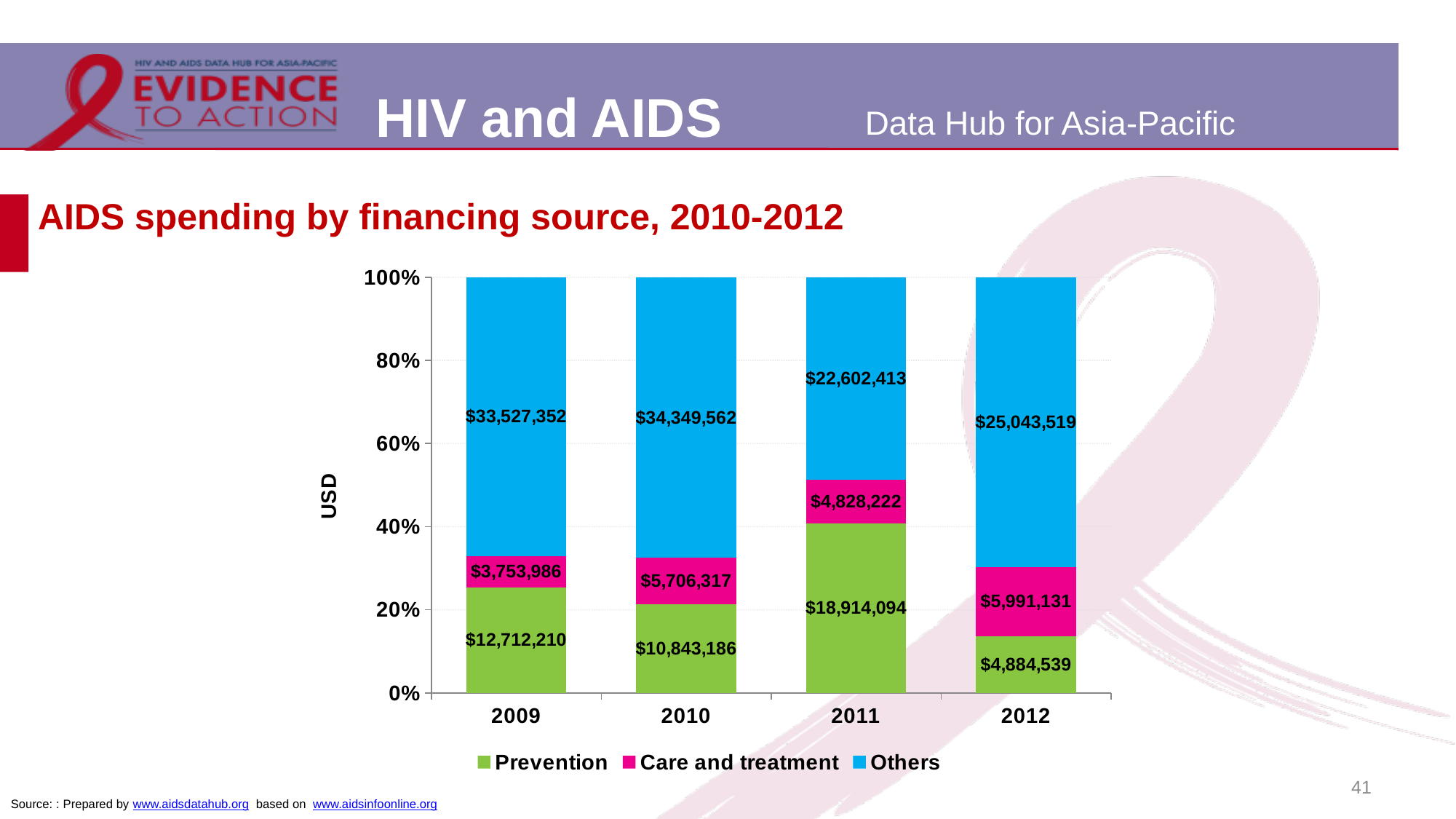
Which is larger, the Care and treatment spending in 2012 or in 2010? 2012 What is the total spending across all three sources for 2009? $49,993,548 What is the Prevention spending value shown for 2011? $18,914,094 What is the difference between the Others spending in 2010 and in 2009? $822,210 How many years are shown on the x axis? 4 What is the Care and treatment spending value shown for 2010? $5,706,317 What is the Others spending value shown for 2012? $25,043,519 What kind of chart is shown on the slide? Stacked bar chart In which year is the Others spending value the lowest? 2011 In which year is the Prevention spending value the highest? 2011 In which year is the Prevention spending value the lowest? 2012 How many series does the legend list? 3